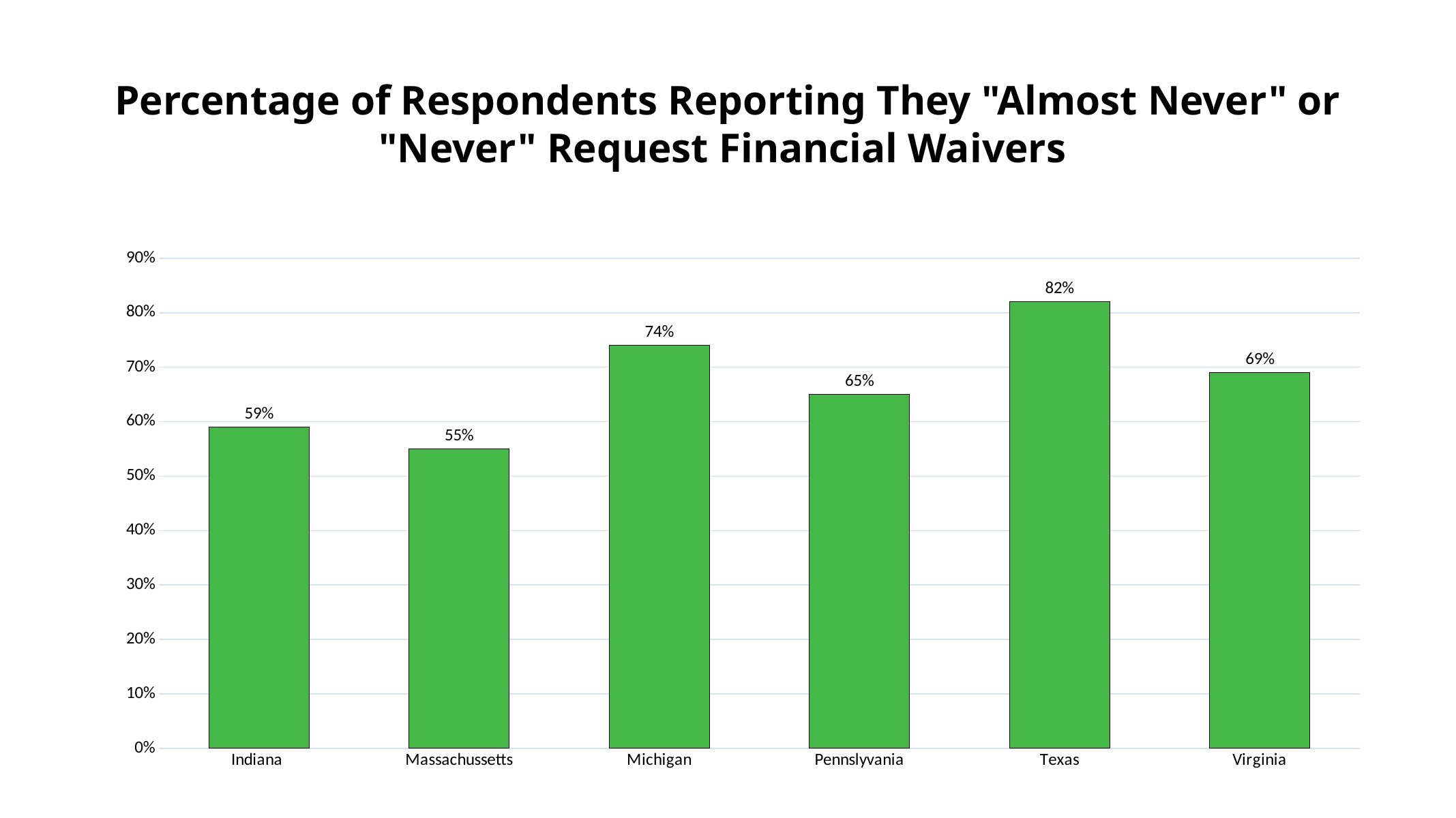
Is the value for Indiana greater or less than 60%? less How many states are shown on the chart? 6 What colour are the bars in the chart? Green What is the value shown for Massachussetts? 55% What is the difference in percentage points between Texas and Indiana? 23 What is the difference in percentage points between Michigan and Pennslyvania? 9 Which has a higher value, Pennslyvania or Virginia? Virginia What percentage of respondents in Texas reported they "almost never" or "never" request financial waivers? 82% Which state has the highest percentage of respondents reporting they "almost never" or "never" request financial waivers? Texas What kind of chart is shown on the slide? Bar chart What is the value shown for Michigan? 74% Which state has the lowest percentage shown on the chart? Massachussetts